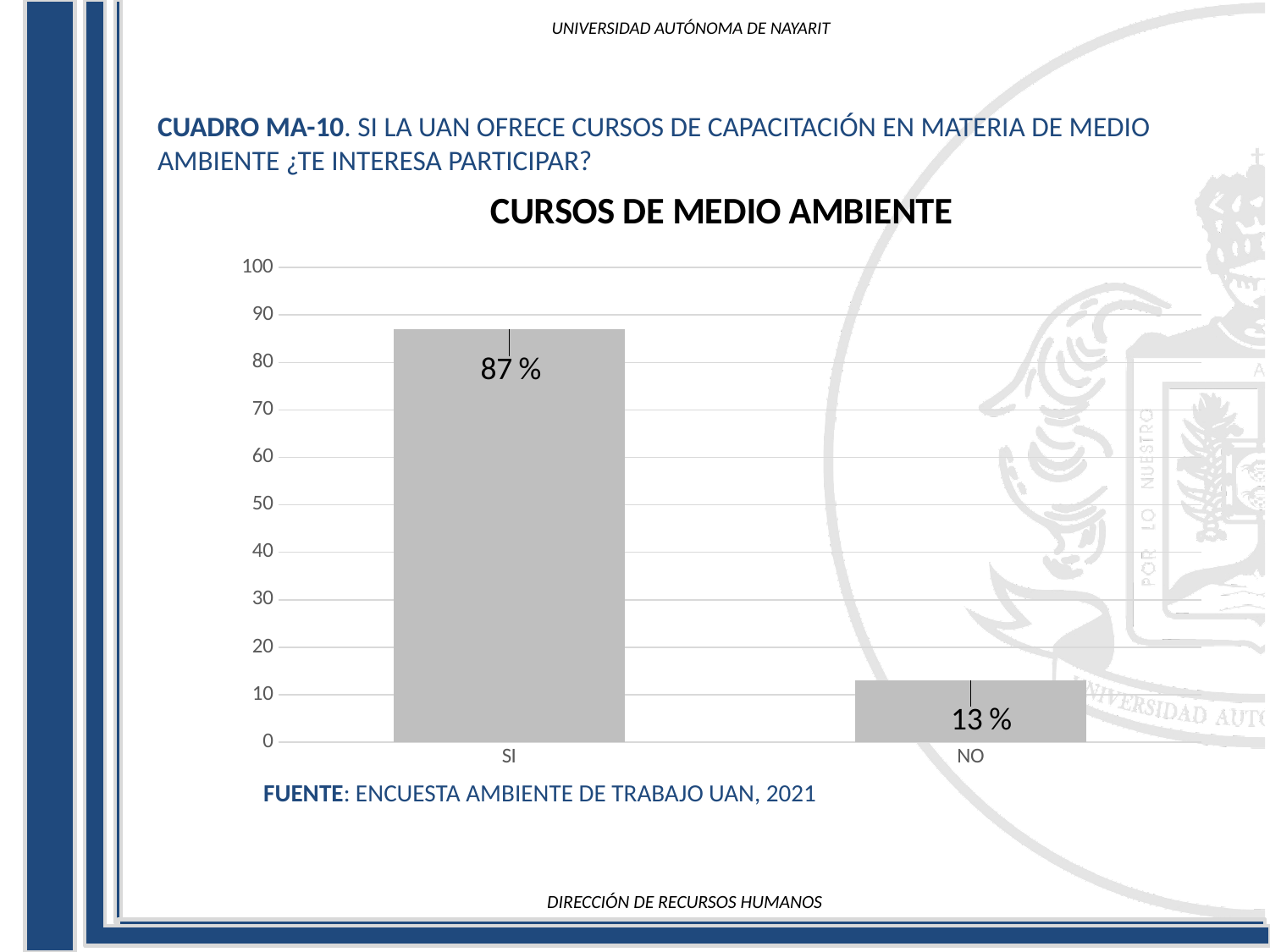
Is the value for SI greater or less than 80? greater What is the title of the chart? CURSOS DE MEDIO AMBIENTE What kind of chart is shown on the slide? bar chart What is the difference between the values for SI and NO? 74 % What is the value for SI? 87 % Which is larger, the value for SI or the value for NO? SI What is the value for NO? 13 % Is the value for NO greater or less than 20? less How many categories are shown in the chart? 2 Which category has the highest value? SI Which category has the lowest value? NO What is the maximum value shown on the vertical axis? 100